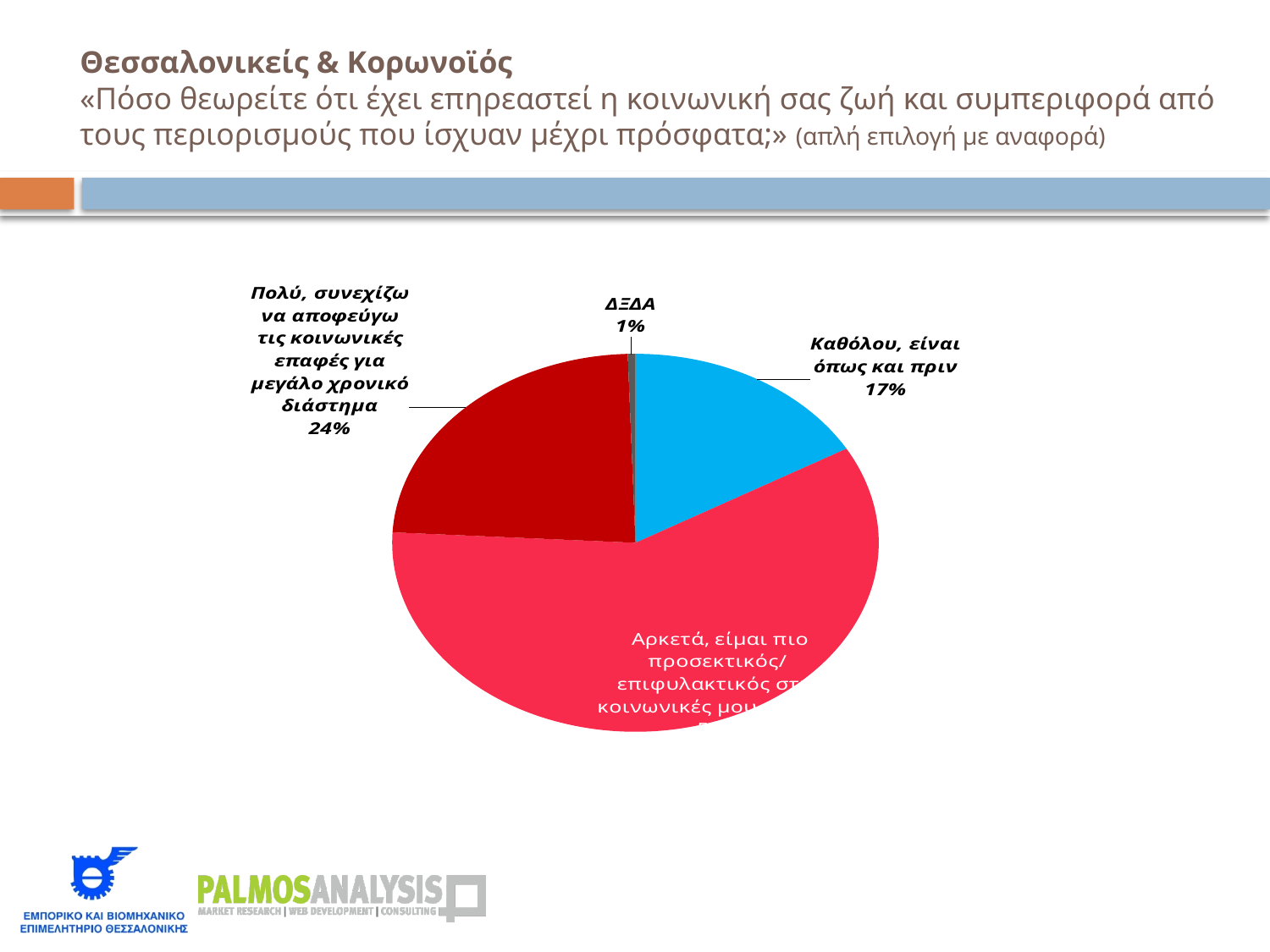
Which is larger: the share for «Πολύ, συνεχίζω να αποφεύγω τις κοινωνικές επαφές» or for «Καθόλου, είναι όπως και πριν»? Πολύ, συνεχίζω να αποφεύγω τις κοινωνικές επαφές What share of respondents answered «Καθόλου, είναι όπως και πριν»? 17% Which answer option has the largest slice of the pie? Αρκετά, είμαι πιο προσεκτικός/επιφυλακτικός How many slices does the pie chart have? 4 By how many percentage points does «Πολύ, συνεχίζω να αποφεύγω τις κοινωνικές επαφές» exceed «Καθόλου, είναι όπως και πριν»? 7 percentage points What colour is the «Πολύ, συνεχίζω να αποφεύγω τις κοινωνικές επαφές» slice? Dark red What colour is the «Καθόλου, είναι όπως και πριν» slice? Light blue Which slice of the pie is the smallest? ΔΞΔΑ What type of chart is shown on the slide? Pie chart What percentage is shown for the «ΔΞΔΑ» slice? 1% What percentage is shown for «Πολύ, συνεχίζω να αποφεύγω τις κοινωνικές επαφές για μεγάλο χρονικό διάστημα»? 24% What is the difference between the «Καθόλου, είναι όπως και πριν» share and the «ΔΞΔΑ» share? 16 percentage points